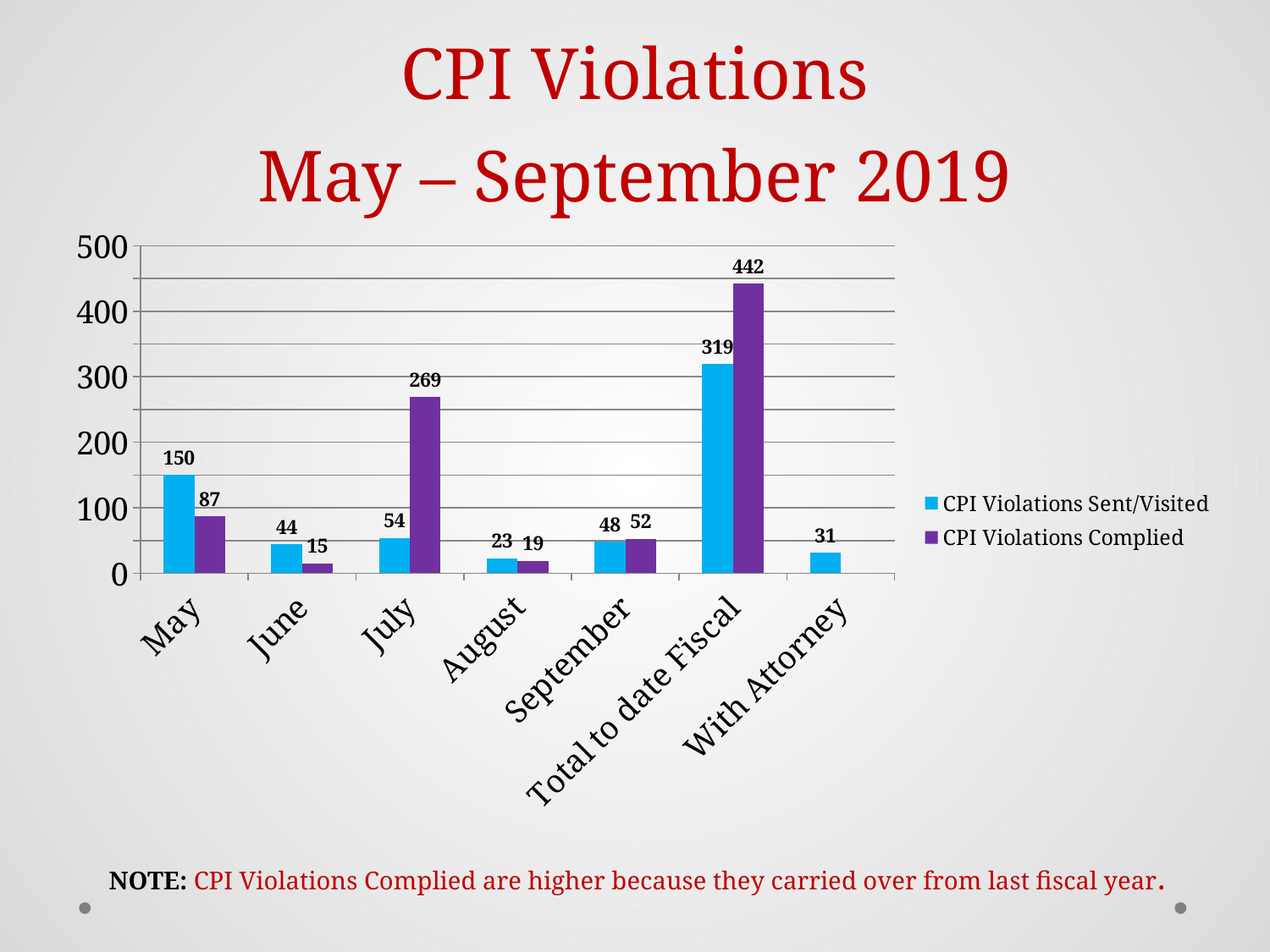
Which category has the highest value for CPI Violations Complied? Total to date Fiscal Is the value of CPI Violations Complied for July greater or less than 200? greater What is the value of CPI Violations Complied for July? 269 Which category has the lowest value for CPI Violations Sent/Visited? August What is the difference between CPI Violations Complied and CPI Violations Sent/Visited for Total to date Fiscal? 123 What colour are the bars for CPI Violations Complied? Purple How many categories are shown on the x axis? 7 What is the value of CPI Violations Sent/Visited for May? 150 Which is larger for June: CPI Violations Sent/Visited or CPI Violations Complied? CPI Violations Sent/Visited What kind of chart is shown on the slide? Bar chart What is the value of CPI Violations Sent/Visited for With Attorney? 31 How many series does the legend list? 2